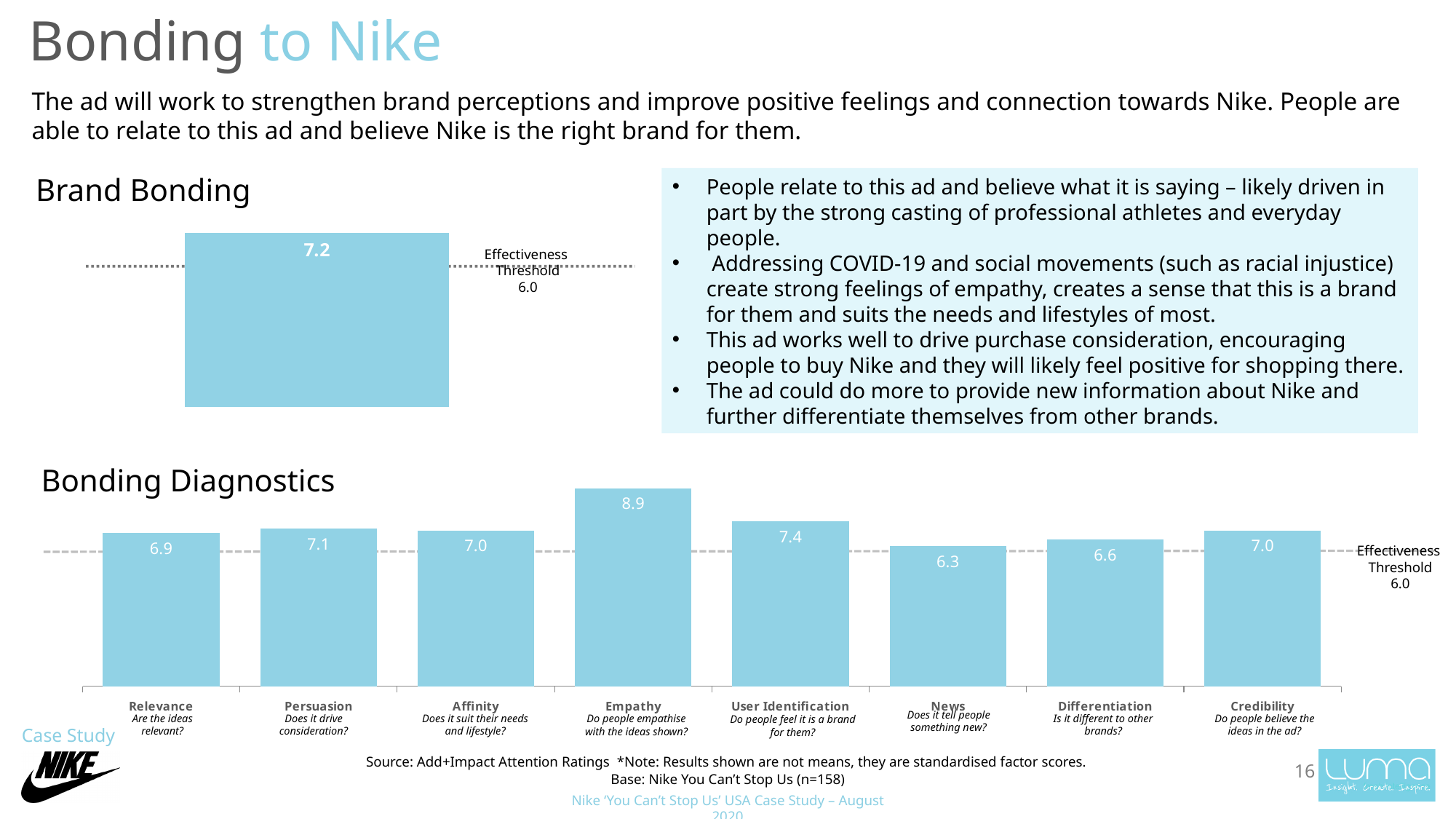
In the Bonding Diagnostics chart, what is the value for User Identification? 7.4 In the Bonding Diagnostics chart, which is larger, Persuasion or Differentiation? Persuasion In the Bonding Diagnostics chart, what is the difference between Empathy and News? 2.6 In the Brand Bonding chart, what is the value of the bar? 7.2 In the Bonding Diagnostics chart, what is the value for Empathy? 8.9 In the Bonding Diagnostics chart, what is the value for News? 6.3 In the Bonding Diagnostics chart, what is the difference between Relevance and Credibility? 0.1 What kind of chart is the Bonding Diagnostics chart? Bar chart In the Bonding Diagnostics chart, which category has the lowest value? News In the Brand Bonding chart, what is the Effectiveness Threshold value shown? 6.0 In the Bonding Diagnostics chart, which category has the highest value? Empathy How many categories are shown in the Bonding Diagnostics chart? 8